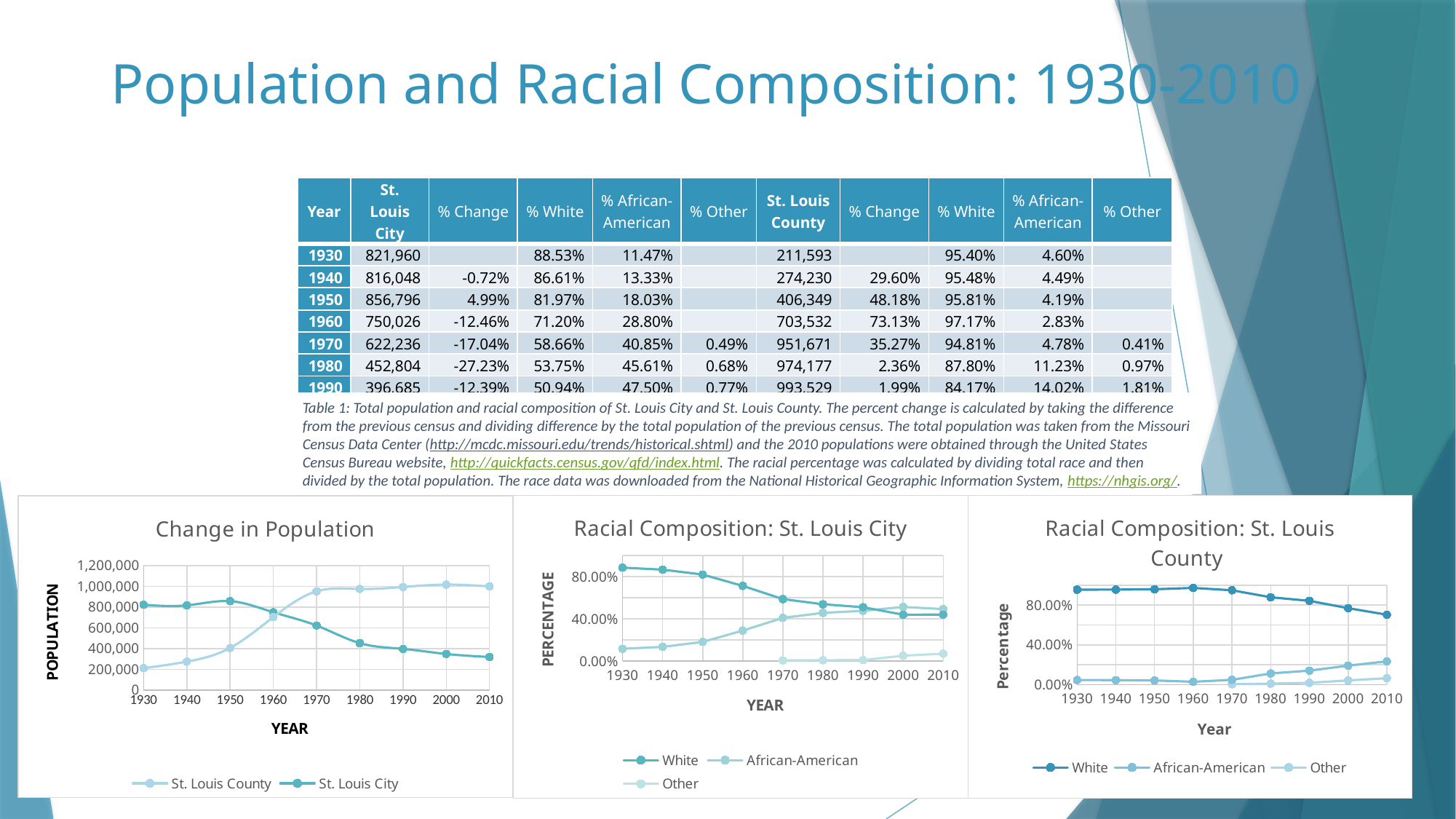
In the "Change in Population" chart, does the St. Louis City population rise or fall from 1950 to 2010? fall In the "Racial Composition: St. Louis City" chart, does the African-American series rise or fall from 1930 to 2010? rise In the "Change in Population" chart, is the St. Louis County value for 2010 greater or less than 800,000? greater In the "Racial Composition: St. Louis County" chart, is the African-American value for 2010 greater or less than 40.00%? less What is the title of the rightmost chart on the slide? Racial Composition: St. Louis County In the "Change in Population" chart, how many years are marked along the x axis? 9 What kind of chart is the "Change in Population" chart? line chart In the "Change in Population" chart, how many series does the legend list? 2 In the "Racial Composition: St. Louis City" chart, which series has the highest value in 1930? White In the "Change in Population" chart, which series has the larger value in 1930, St. Louis County or St. Louis City? St. Louis City In the "Racial Composition: St. Louis County" chart, how many series does the legend list? 3 In the "Racial Composition: St. Louis City" chart, is the White value for 2010 greater or less than 80.00%? less